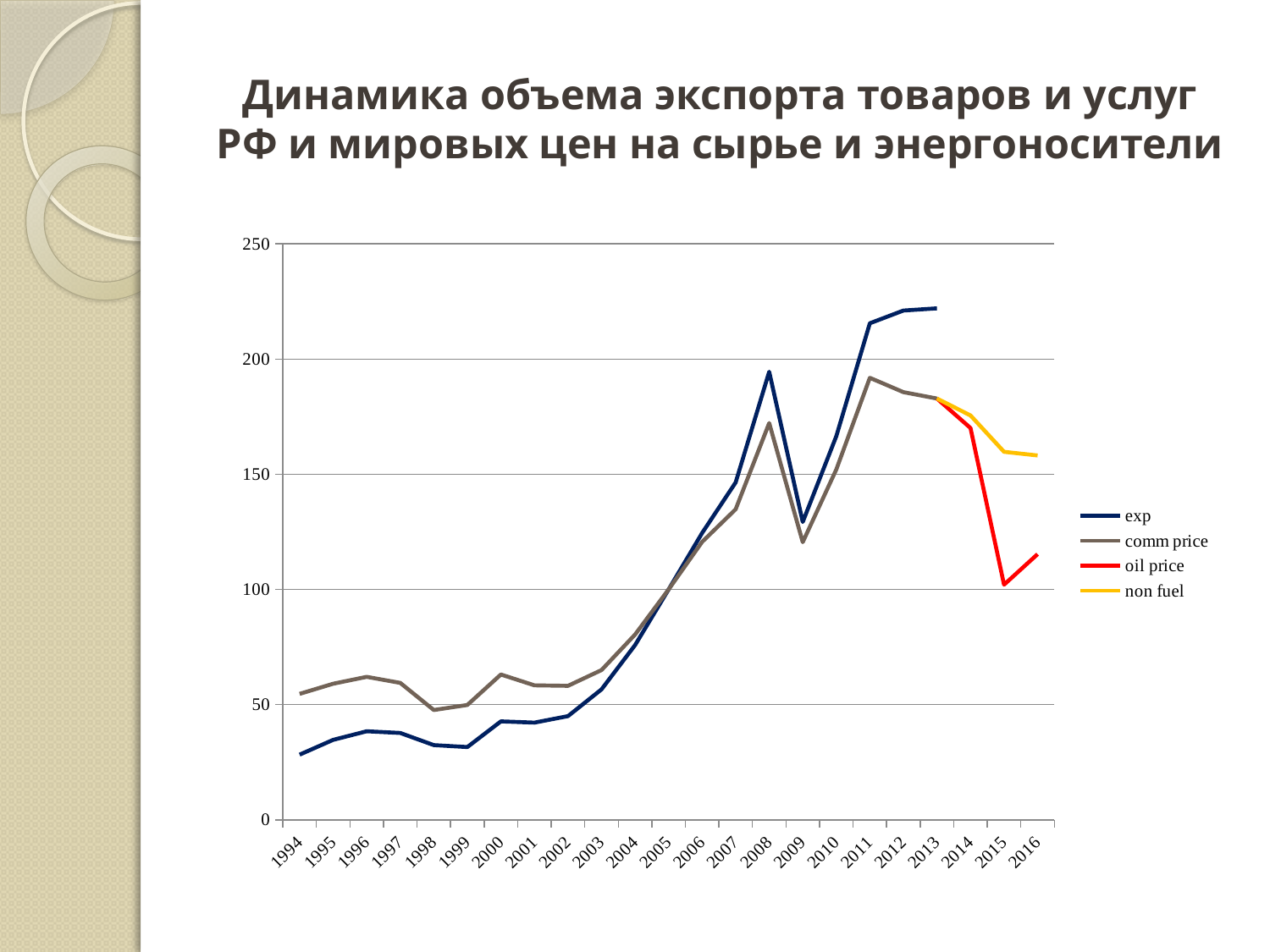
Is the value of the comm price series in 2009 greater or less than 100? greater How many years are shown on the x axis? 23 Is the value of the oil price series in 2015 greater or less than 150? less In which year does the comm price series reach its highest value? 2011 What kind of chart is shown on the slide? line chart Does the oil price series rise or fall from 2013 to 2015? fall Is the value of the exp series in 1994 greater or less than 50? less In which year does the oil price series reach its lowest value? 2015 How many series does the legend list? 4 In 2015, which series has the larger value: oil price or non fuel? non fuel